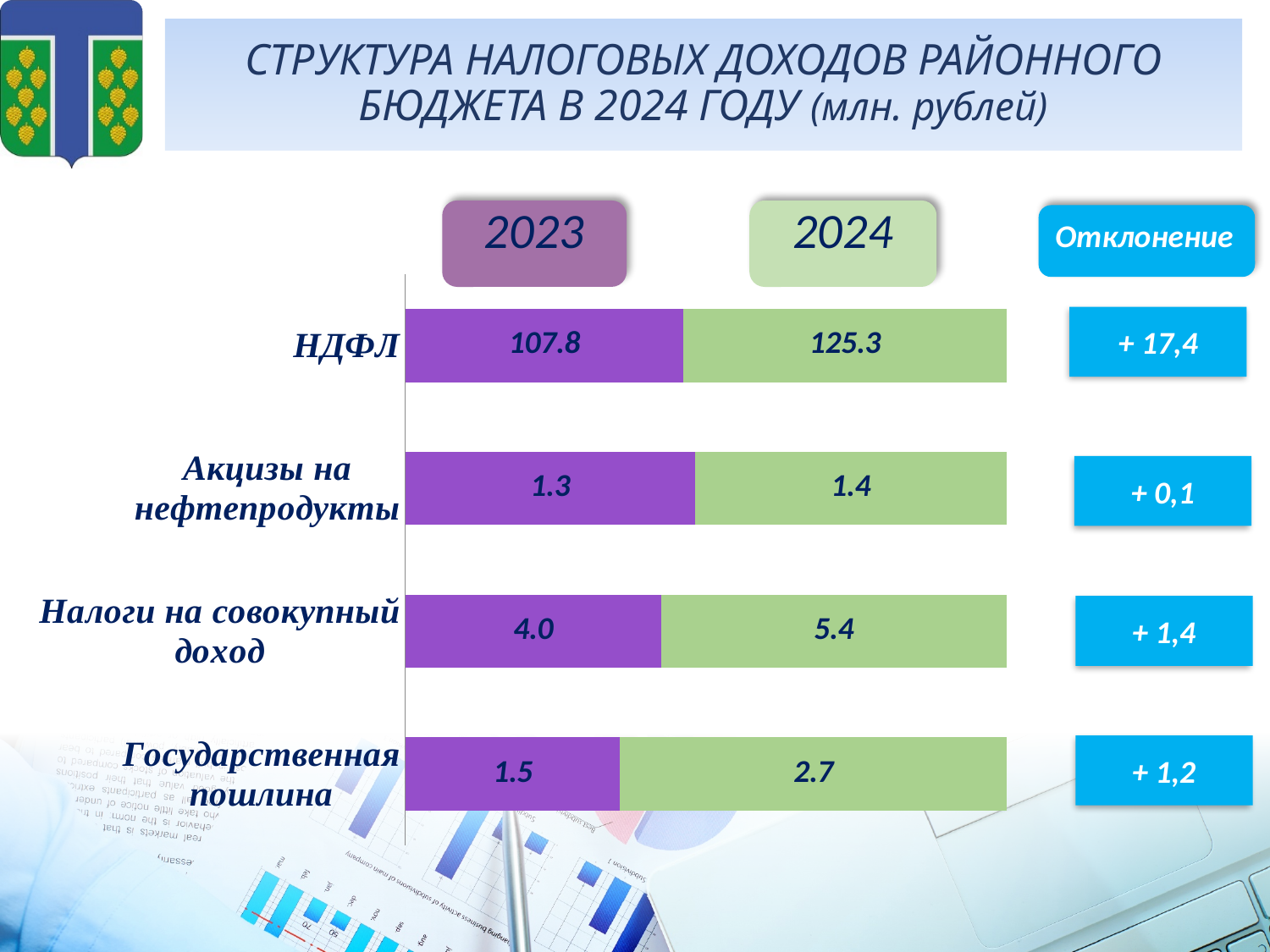
Which category has the highest 2024 value? НДФЛ How many categories are shown in the chart? 4 What is the 2024 value for Государственная пошлина? 2.7 How many series does the chart show? 2 Which category has the lowest 2023 value? Акцизы на нефтепродукты What is the 2024 value for Налоги на совокупный доход? 5.4 What is the difference between the 2024 and 2023 values for Налоги на совокупный доход? 1.4 For Акцизы на нефтепродукты, which year has the larger value, 2023 or 2024? 2024 What kind of chart is shown on the slide? Bar chart What is the difference between the 2024 and 2023 values for Государственная пошлина? 1.2 What is the 2023 value for НДФЛ? 107.8 What deviation (Отклонение) is shown for НДФЛ? + 17,4